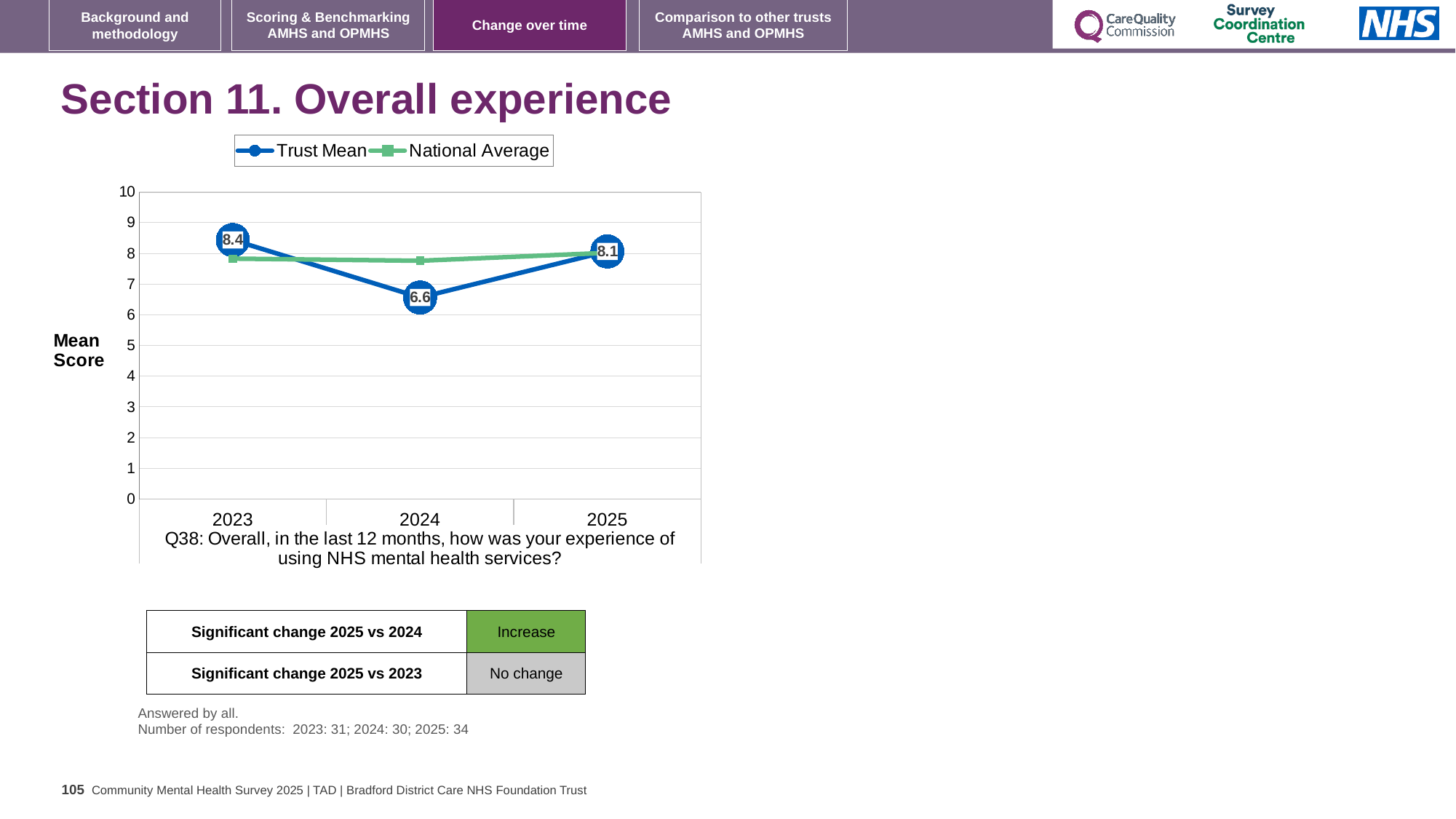
Is the National Average value for 2024 greater or less than 7? greater What is the Trust Mean score for 2025? 8.1 In which year is the Trust Mean score highest? 2023 How many series does the legend list? 2 What is the Trust Mean score for 2023? 8.4 How many years are plotted on the x axis? 3 Does the Trust Mean rise or fall from 2024 to 2025? Rise In 2024, which is higher: the Trust Mean or the National Average? National Average What kind of chart is shown on the slide? Line chart What is the difference between the Trust Mean scores for 2023 and 2024? 1.8 What is the Trust Mean score for 2024? 6.6 In which year is the Trust Mean score lowest? 2024